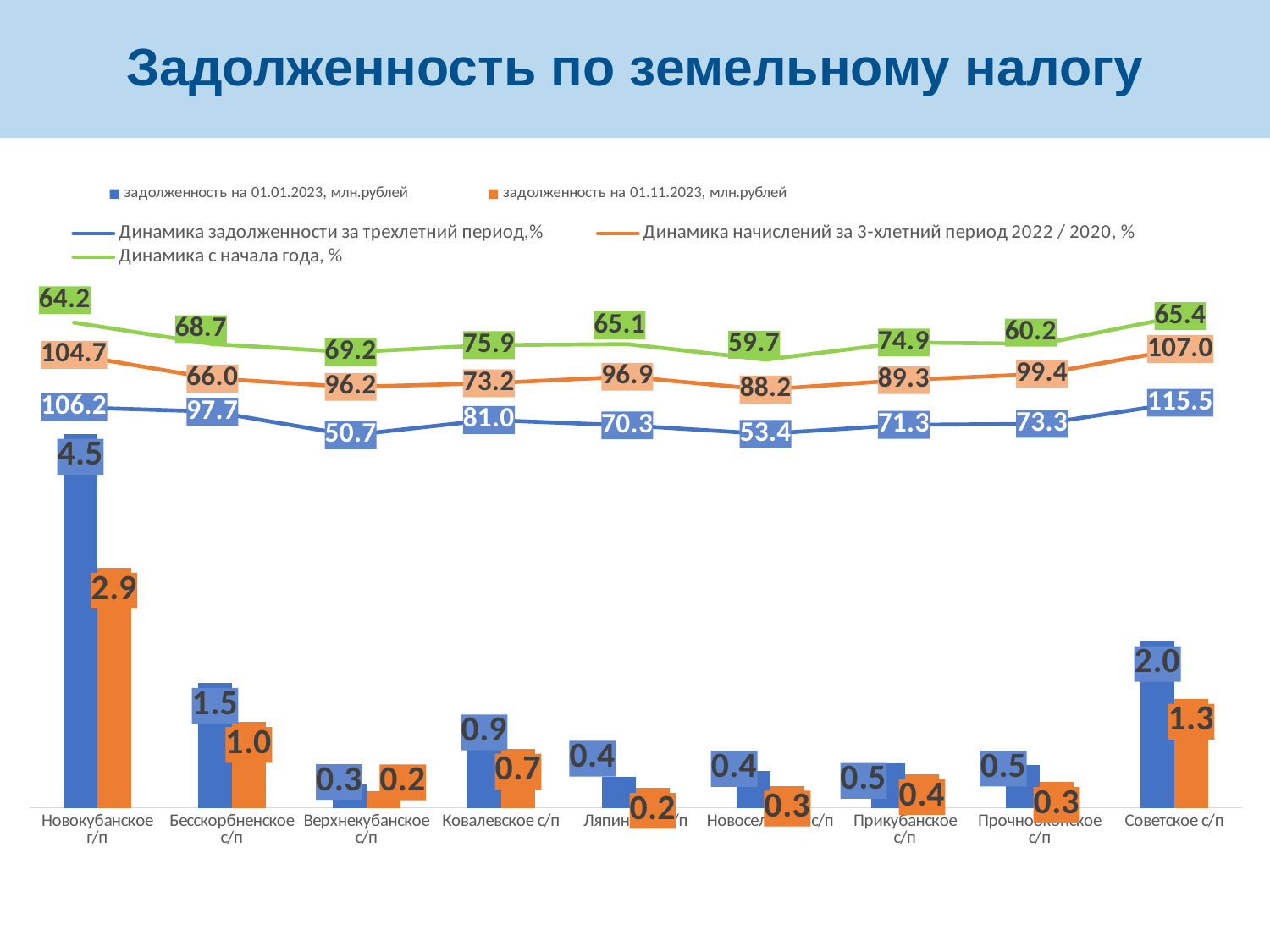
What is the difference between задолженность на 01.01.2023 and задолженность на 01.11.2023 for Новокубанское г/п? 1.6 Which category has the highest value of задолженность на 01.01.2023, млн.рублей? Новокубанское г/п Which is larger for Советское с/п: Динамика задолженности за трехлетний период,% or Динамика начислений за 3-хлетний период 2022 / 2020, %? Динамика задолженности за трехлетний период,% How many categories are shown on the x axis of the chart? 9 Which category has the lowest value of Динамика задолженности за трехлетний период,%? Верхнекубанское с/п What is the value of Динамика с начала года, % for Ковалевское с/п? 75.9 What is the value of Динамика задолженности за трехлетний период,% for Верхнекубанское с/п? 50.7 How many series does the legend list? 5 What is the value of задолженность на 01.01.2023, млн.рублей for Новокубанское г/п? 4.5 What is the value of задолженность на 01.11.2023, млн.рублей for Советское с/п? 1.3 What is the title of the slide? Задолженность по земельному налогу What is the value of Динамика начислений за 3-хлетний период 2022 / 2020, % for Бесскорбненское с/п? 66.0